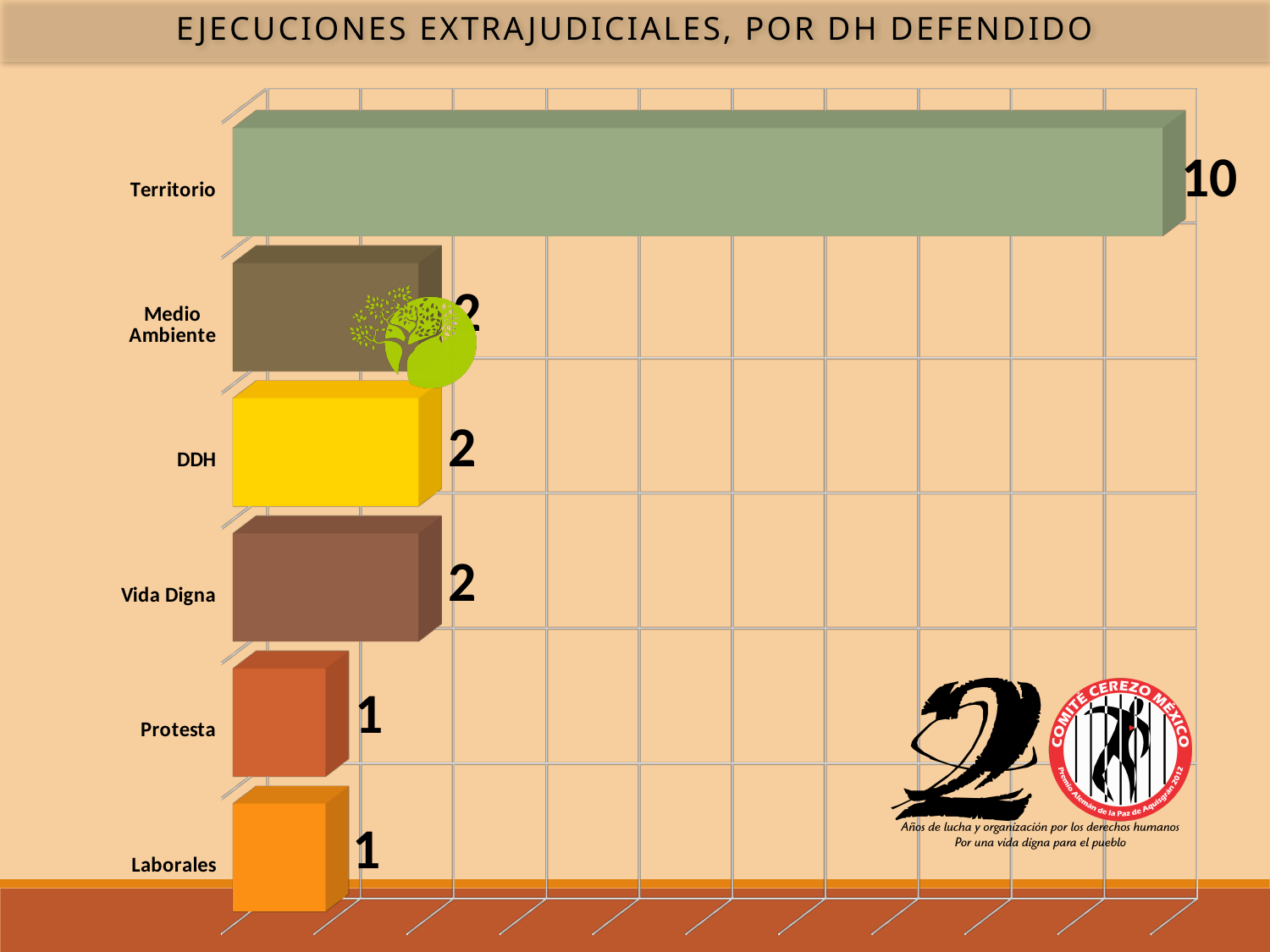
What is the value for Protesta? 1 What is the value for Vida Digna? 2 What is the difference between the values for Territorio and DDH? 8 Which category has the highest value? Territorio What is the value for Territorio? 10 What is the value for DDH? 2 How many categories are shown in the chart? 6 Which is larger, the value for Territorio or the value for Vida Digna? Territorio What is the value for Medio Ambiente? 2 What is the value for Laborales? 1 What kind of chart is shown on the slide? Bar chart What is the title of the chart? EJECUCIONES EXTRAJUDICIALES, POR DH DEFENDIDO